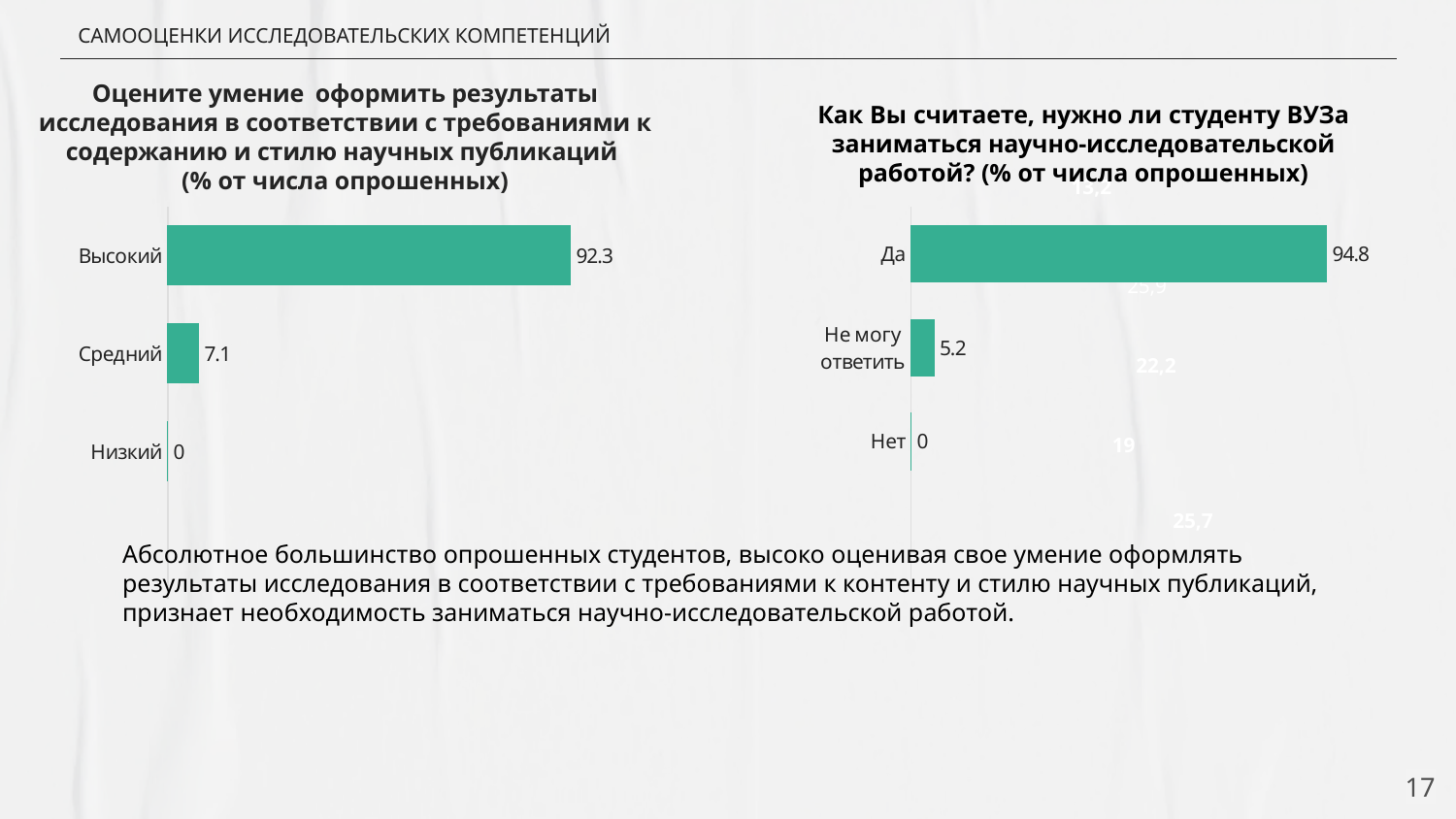
In the right chart, what is the value for Да? 94.8 In the left chart, what is the difference between the values for Высокий and Средний? 85.2 What type of chart is the left chart? Bar chart How many categories are shown in the right chart? 3 In the left chart, which category has the highest value? Высокий In the right chart, which is larger, the value for Да or the value for Не могу ответить? Да In the right chart, which category has the lowest value? Нет In the left chart, what is the value for Низкий? 0 In the right chart, what is the value for Нет? 0 In the left chart, what is the value for Средний? 7.1 In the left chart, what is the value for Высокий? 92.3 In the right chart, what is the value for Не могу ответить? 5.2